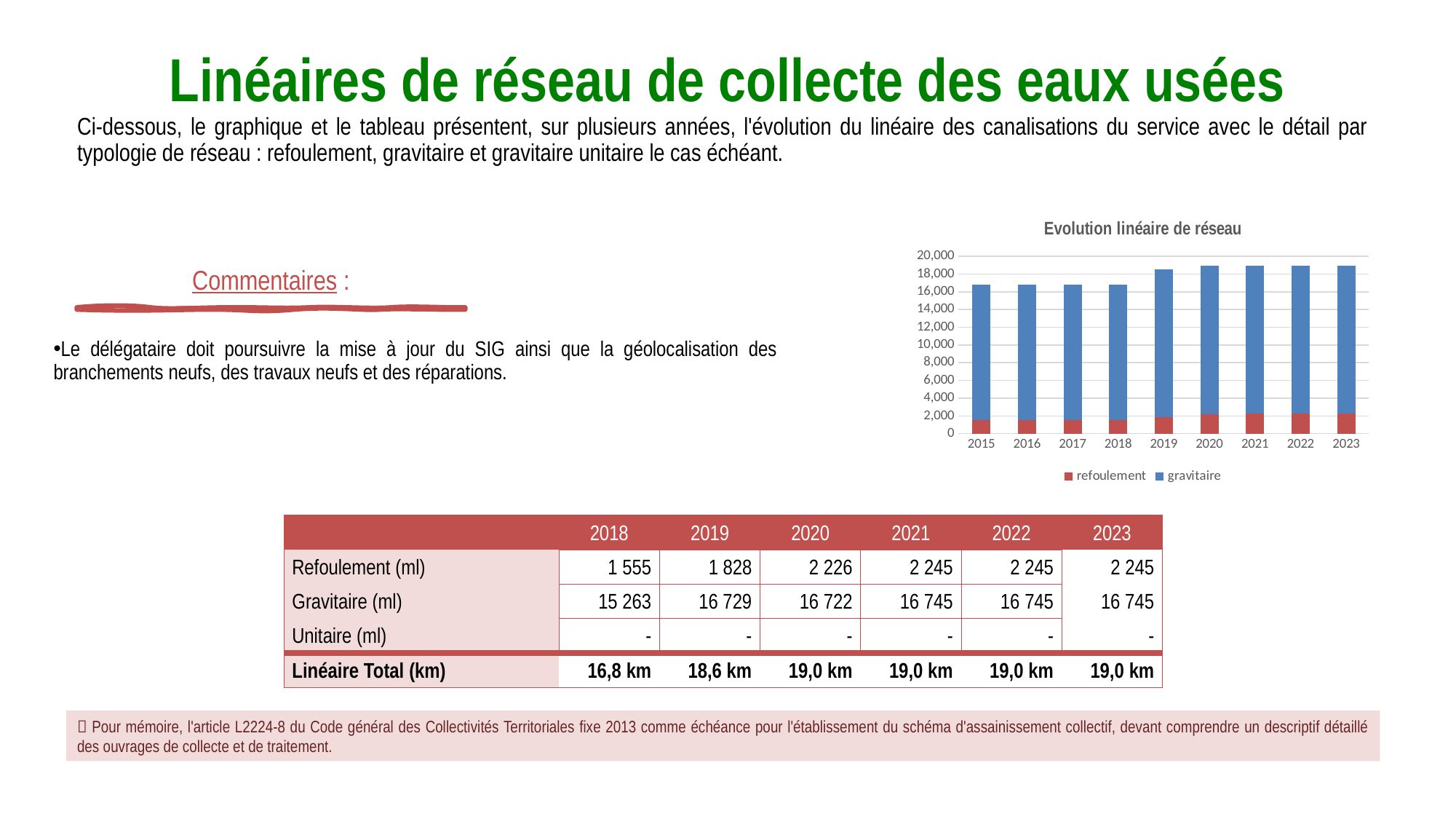
Is the total height of the 2021 bar greater or less than 18,000? greater Is the total height of the 2020 bar greater or less than 20,000? less How many years are shown on the x axis of the chart? 9 Is the refoulement value for 2015 greater or less than 2,000? less What kind of chart is 'Evolution linéaire de réseau'? stacked bar chart How many series does the legend of the chart list? 2 Does the total network length rise or fall from 2015 to 2023 in the chart? rise What is the title of the chart on the slide? Evolution linéaire de réseau Which series is shown in red in the chart? refoulement Which year has the taller total bar, 2018 or 2019? 2019